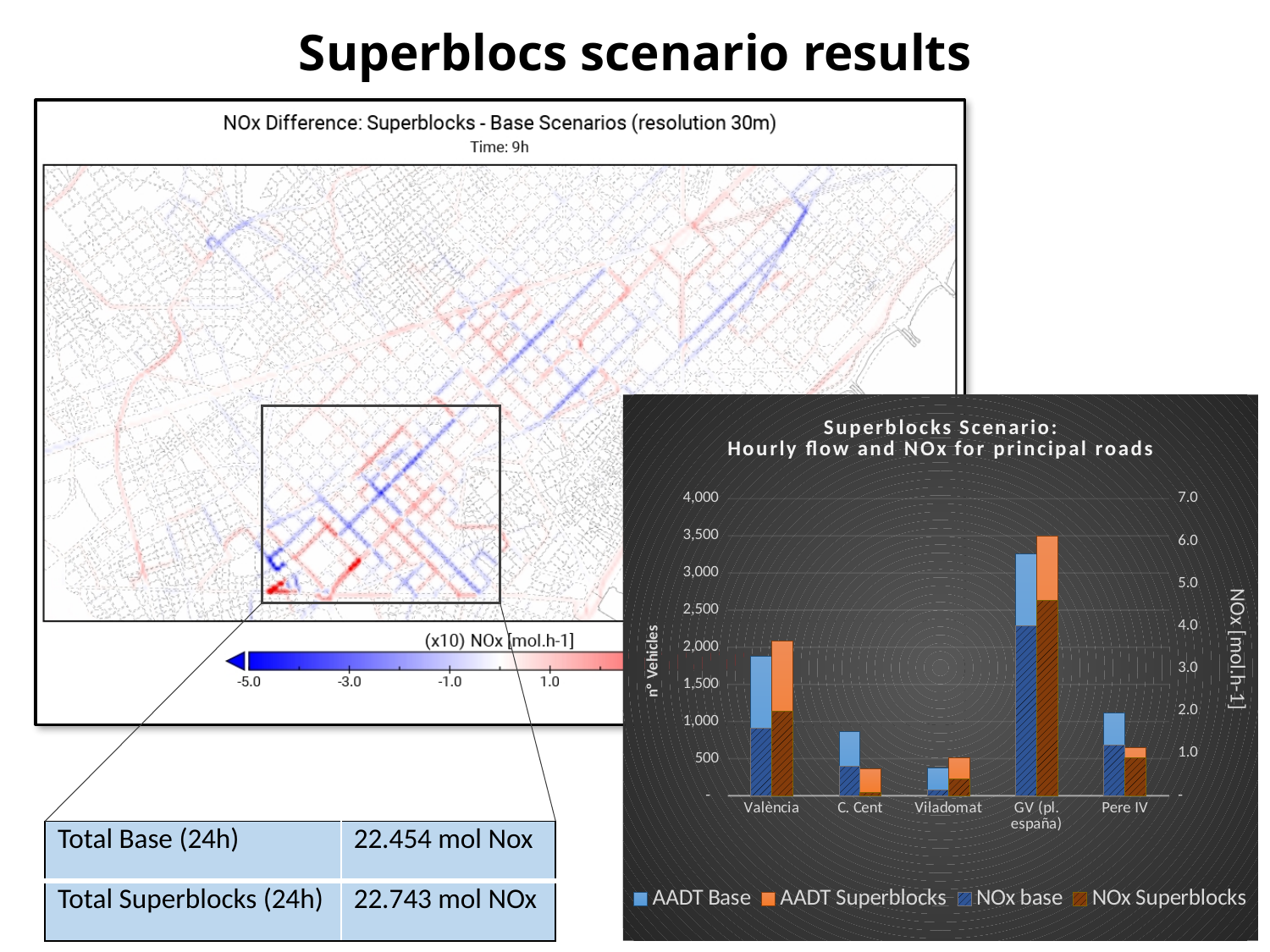
In the bar chart, which is larger for València: AADT Base or AADT Superblocks? AADT Superblocks In the bar chart, is the AADT Base value for GV (pl. españa) greater or less than 3,000? greater In the bar chart, is the AADT Base value for C. Cent greater or less than 500? greater In the bar chart, which road has the lowest AADT Base value? Viladomat In the bar chart, which road has the highest AADT Base value? GV (pl. españa) In the bar chart, is the AADT Base value for Viladomat greater or less than 500? less How many roads (categories) are shown on the x axis of the bar chart? 5 What is the label of the right-hand vertical axis of the bar chart? NOx [mol.h-1] How many series does the legend of the bar chart list? 4 What kind of chart is 'Superblocks Scenario: Hourly flow and NOx for principal roads'? bar chart In the bar chart, which is larger for C. Cent: AADT Base or AADT Superblocks? AADT Base